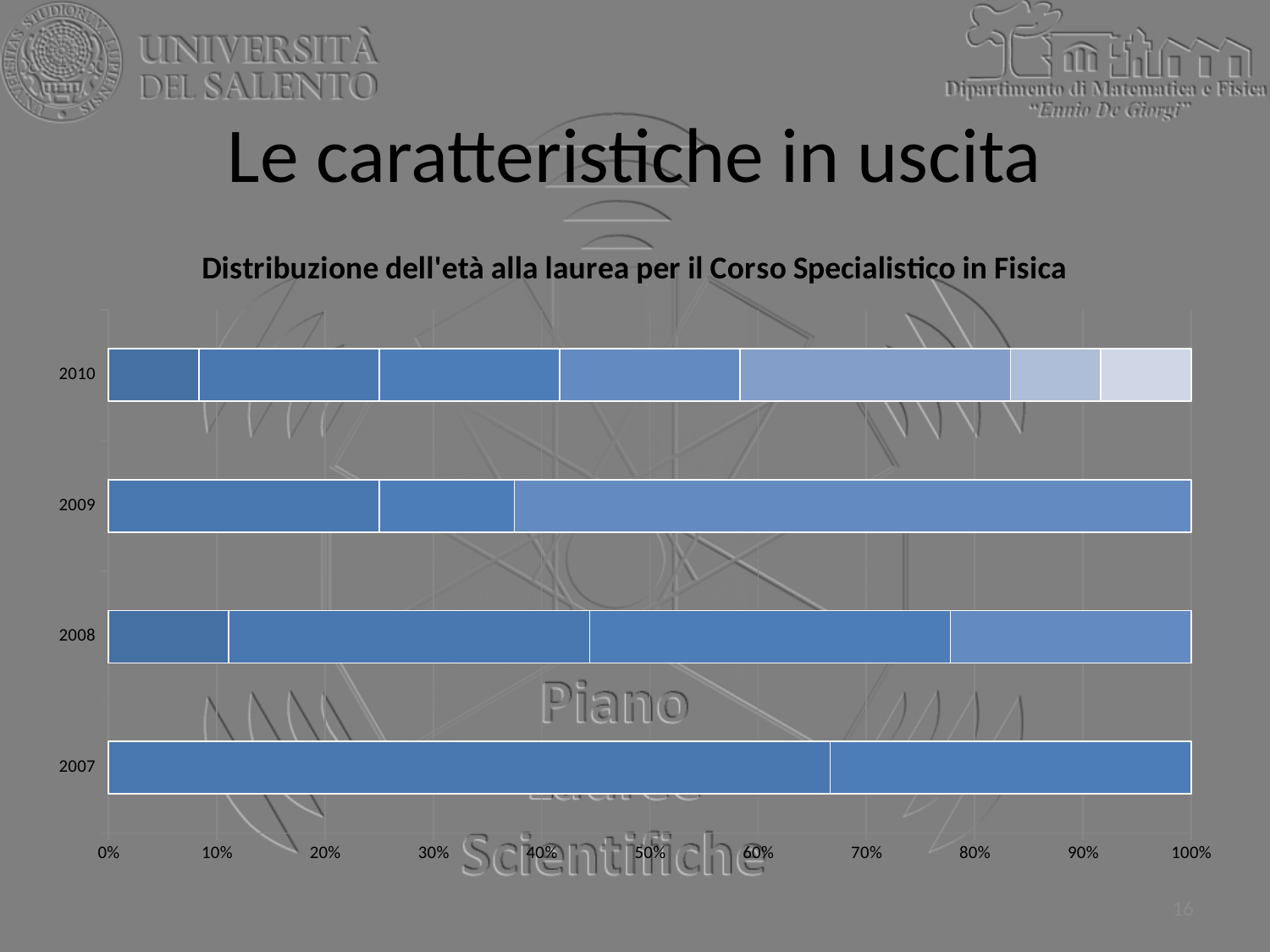
How many segments make up the bar for 2009? 3 What kind of chart is shown on the slide? stacked bar chart Which year's bar is divided into the most segments? 2010 Which years are shown as categories on the chart? 2007, 2008, 2009, 2010 What is the title of the chart? Distribuzione dell'età alla laurea per il Corso Specialistico in Fisica Is the leftmost segment of the 2007 bar greater or less than 60%? greater How many segments make up the bar for 2010? 7 How many segments make up the bar for 2007? 2 Is the leftmost segment of the 2010 bar greater or less than 10%? less Which year's bar is divided into the fewest segments? 2007